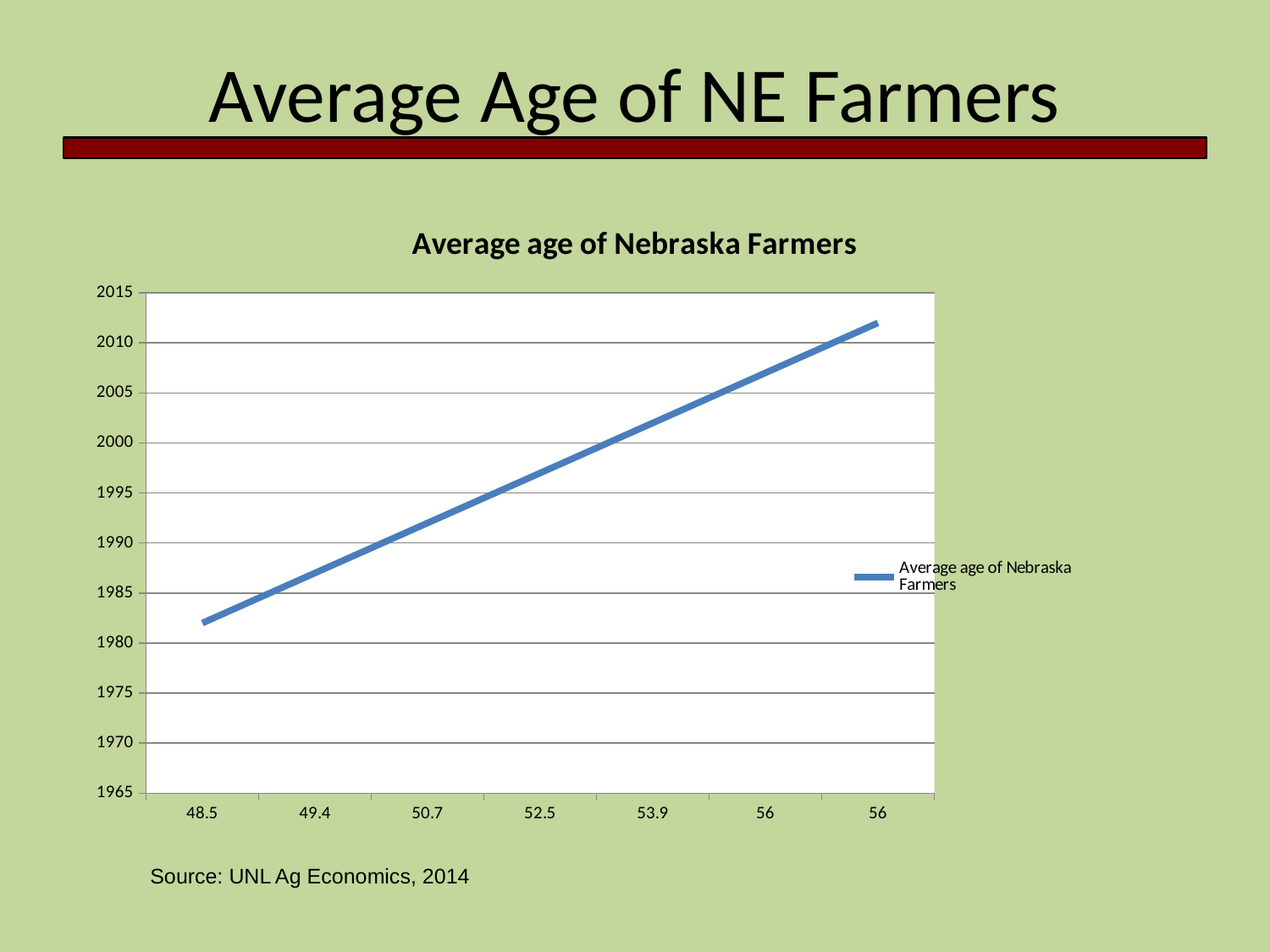
Do the values rise or fall along the x axis? rise Is the value for 53.9 greater or less than 2000? greater How many series does the legend list? 1 Which x-axis category has the lowest value? 48.5 What is the source cited below the chart? UNL Ag Economics, 2014 Is the value for 48.5 greater or less than 1985? less What kind of chart is shown on the slide? line chart Which is larger, the value for 53.9 or the value for 50.7? 53.9 Is the value for 50.7 greater or less than 1990? greater How many categories are shown on the x axis? 7 What is the title of the chart? Average age of Nebraska Farmers